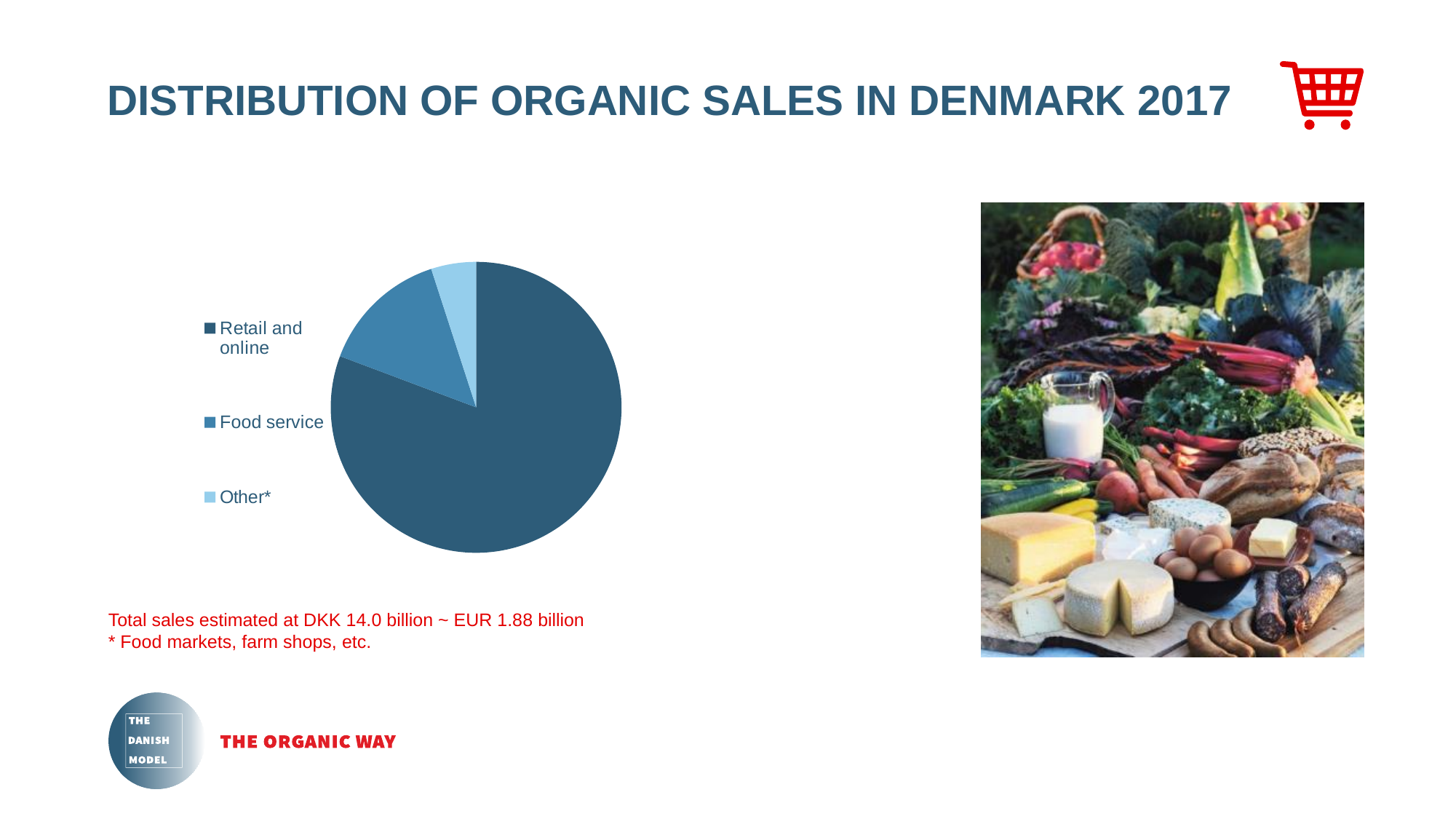
What kind of chart is shown on the slide? Pie chart How many slices does the pie chart have? 3 Which category has the smallest share of organic sales in the pie chart? Other* Which legend entry is shown in the lightest blue colour? Other* How many entries does the legend of the pie chart list? 3 Is the share for Retail and online greater or less than half of the pie? greater Which category has the largest share of organic sales in the pie chart? Retail and online What is the title of the slide containing the pie chart? DISTRIBUTION OF ORGANIC SALES IN DENMARK 2017 Which slice is larger, Food service or Other*? Food service Which slice is larger, Retail and online or Food service? Retail and online